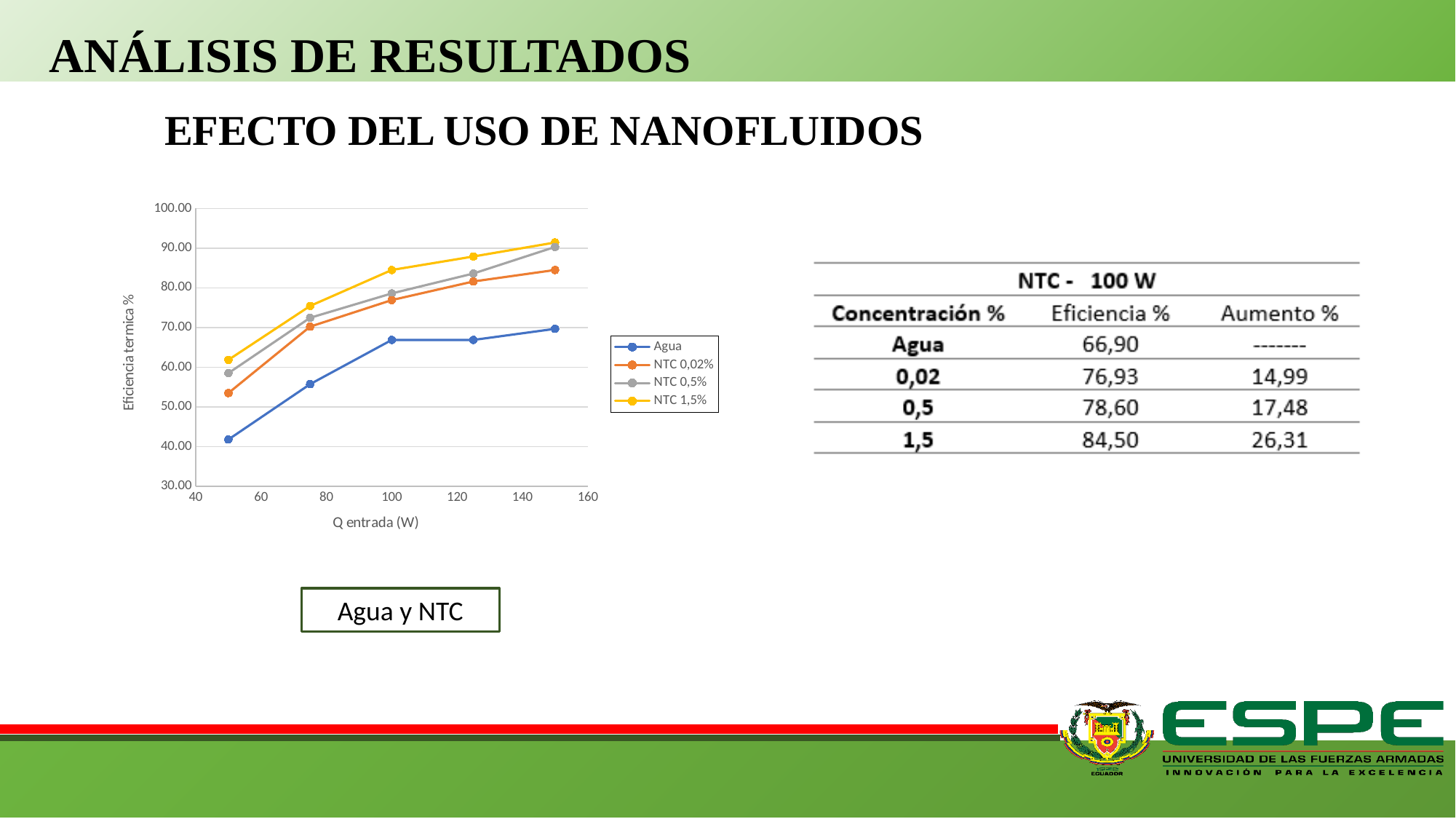
Is the value for NTC 0,5% at 50 W greater or less than 60? less Which series has the highest efficiency at 150 W? NTC 1,5% At 50 W, which is larger: the value for NTC 0,02% or the value for Agua? NTC 0,02% What is the title of the x axis of the chart? Q entrada (W) Is the value for NTC 0,02% at 150 W greater or less than 80? greater How many series does the chart legend list? 4 Is the value for Agua at 50 W greater or less than 50? less How many data points are plotted for the Agua series? 5 Which series has the lowest efficiency at 100 W? Agua Do the values for NTC 1,5% rise or fall as Q entrada increases? rise What kind of chart is shown on the slide? line chart